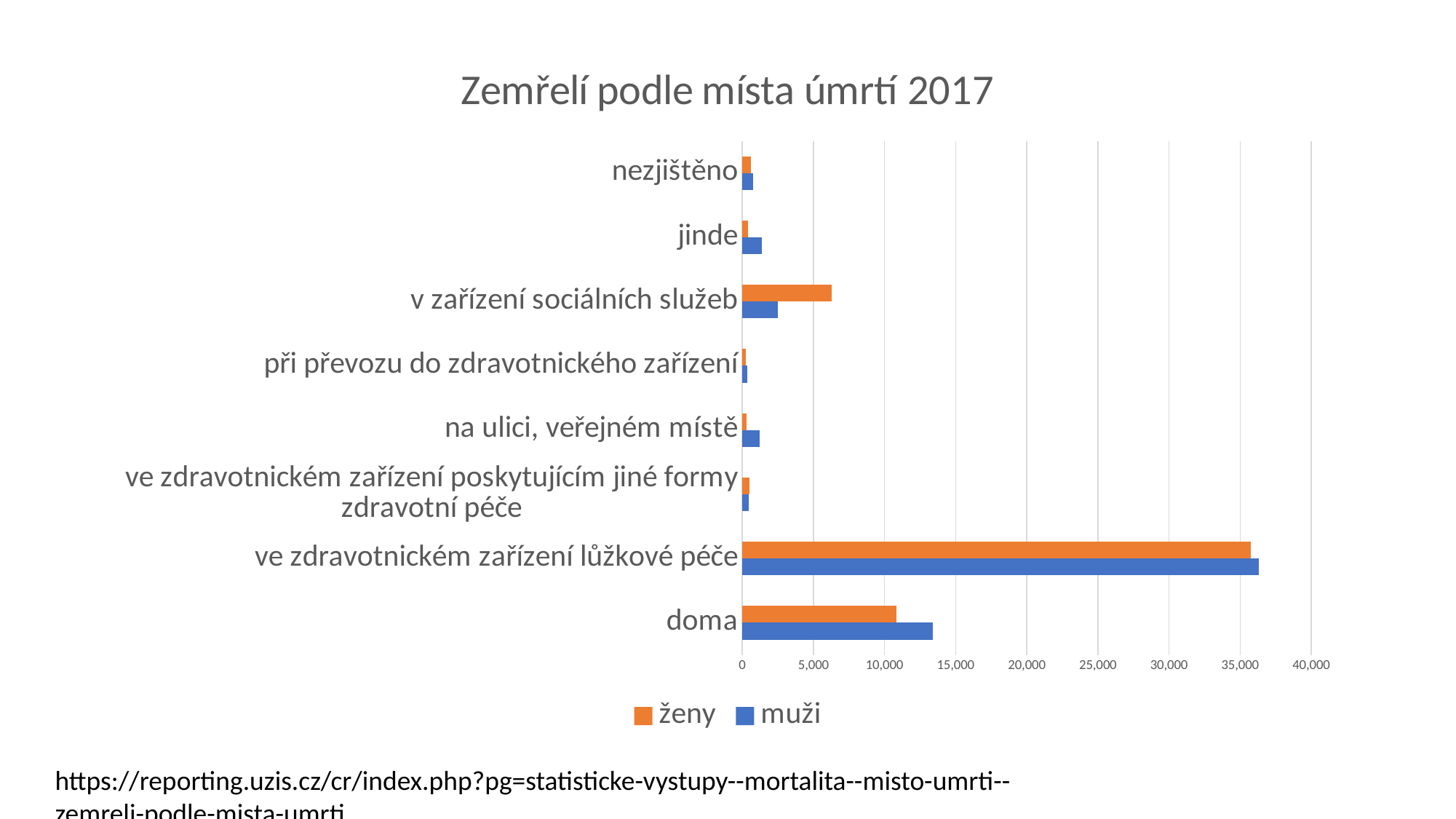
How many series does the legend list? 2 Which category has the highest value for ženy? ve zdravotnickém zařízení lůžkové péče In the category 'v zařízení sociálních služeb', which series has the larger value, ženy or muži? ženy Is the value for ženy in the category 'doma' greater or less than 10,000? greater What is the title of the chart? Zemřelí podle místa úmrtí 2017 Is the value for muži in the category 've zdravotnickém zařízení lůžkové péče' greater or less than 35,000? greater In the category 'doma', which series has the larger value, ženy or muži? muži What kind of chart is shown on the slide? bar chart Which category has the highest value for muži? ve zdravotnickém zařízení lůžkové péče How many categories are shown on the chart? 8 Is the value for muži in the category 'doma' greater or less than 15,000? less